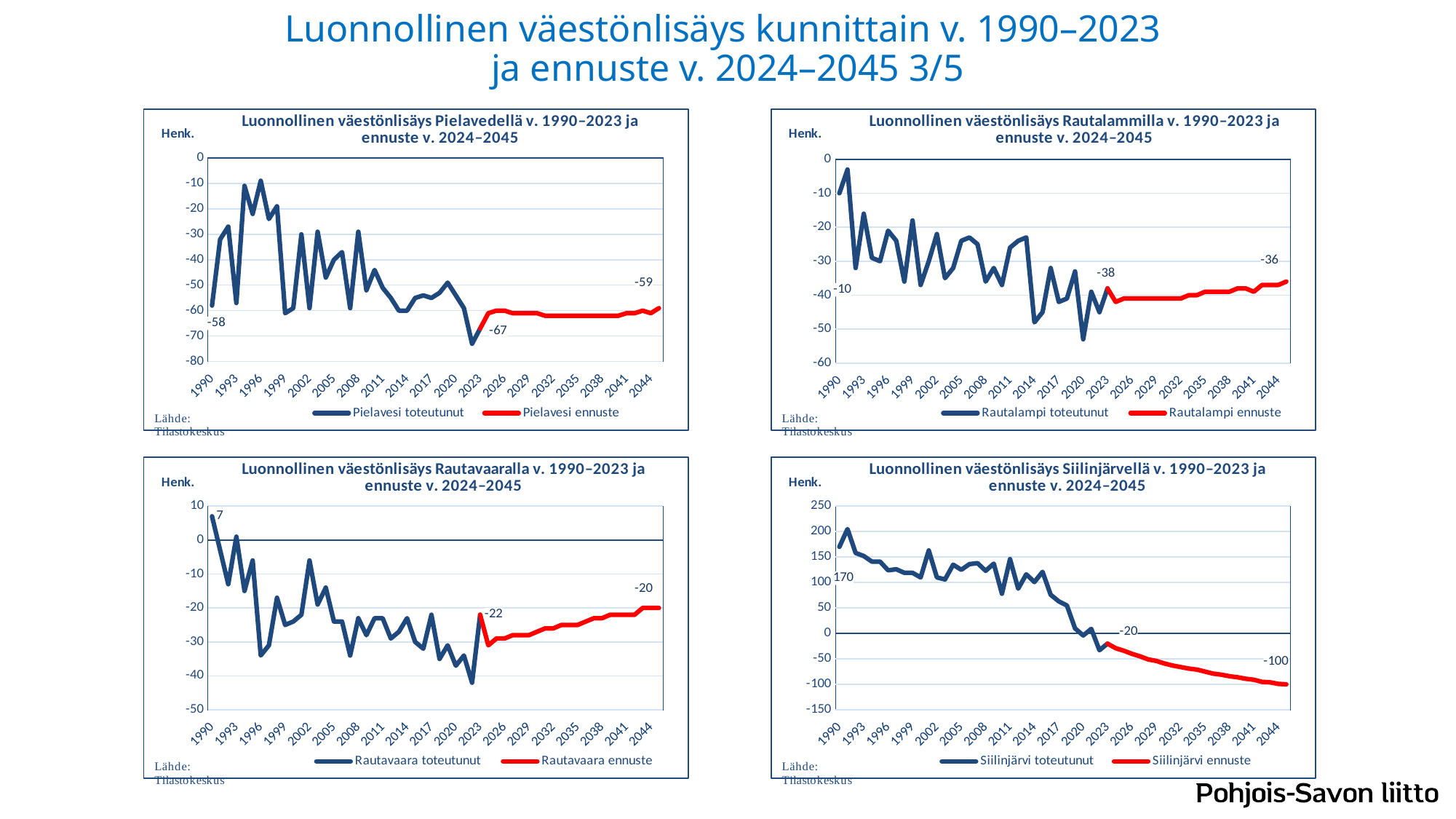
In the Rautalampi chart (top right), is the value for 2023 greater or less than -30? less In the Rautalampi chart (top right), what is the labelled forecast value for 2045? -36 In the Siilinjärvi chart (bottom right), what is the labelled forecast value for 2045? -100 In the Rautavaara chart (bottom left), what is the labelled value for 1990? 7 In the Rautavaara chart (bottom left), which is larger, the 2023 value or the 2045 forecast value? 2045 forecast value (-20) In the Siilinjärvi chart (bottom right), does the forecast line rise or fall from 2024 to 2045? fall In the Pielavesi chart (top left), what is the labelled value for 2023? -67 How many series does the legend of the Pielavesi chart (top left) list? 2 What kind of chart is the Rautalampi chart (top right)? line chart In the Siilinjärvi chart (bottom right), what is the labelled value for 1990? 170 In the Siilinjärvi chart (bottom right), what is the difference between the 1990 value and the 2023 value? 190 In the Pielavesi chart (top left), what is the labelled value for 1990? -58